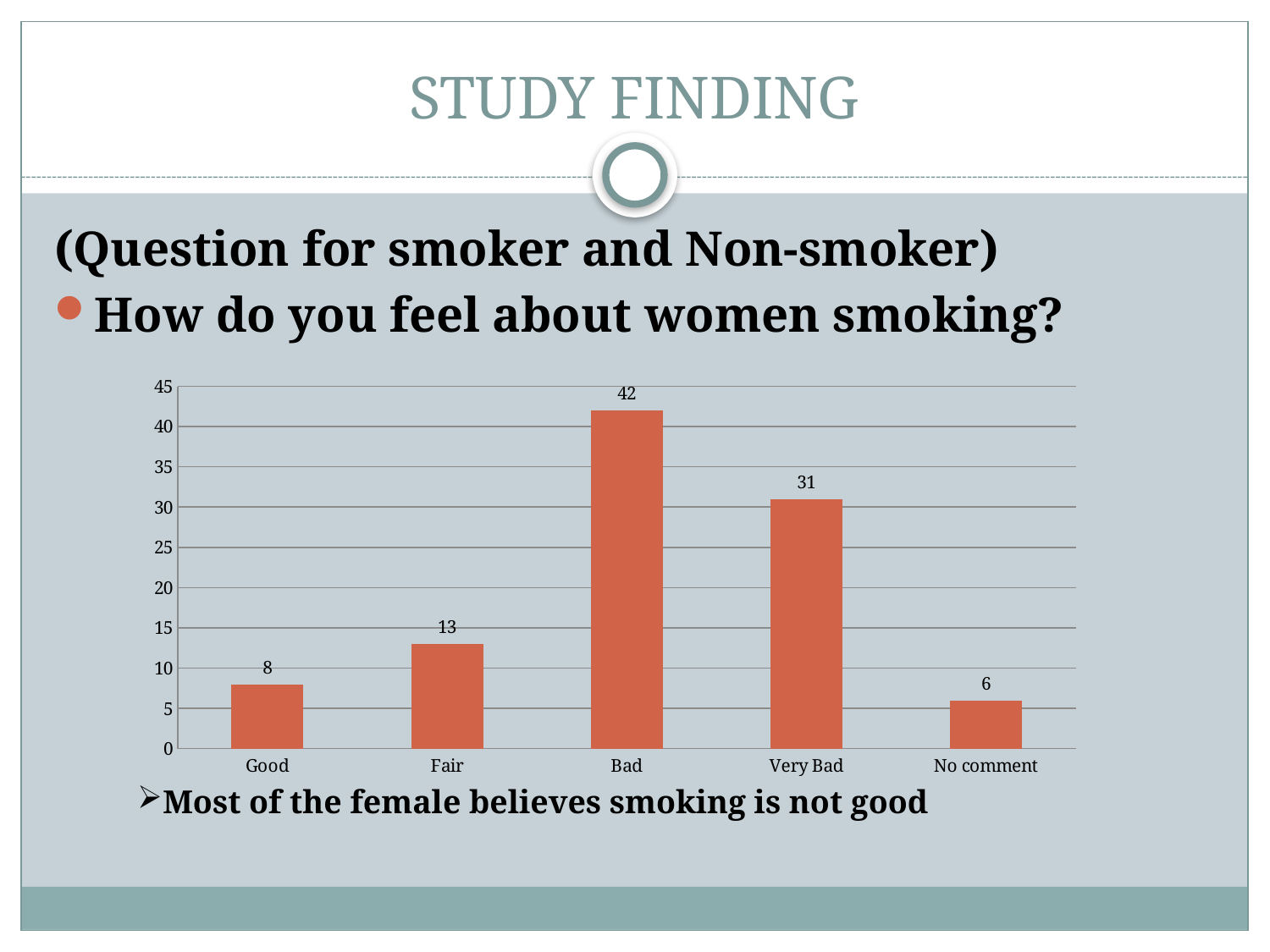
Is the value for Very Bad greater or less than 25? greater What is the difference between the values for Good and No comment? 2 What is the difference between the values for Bad and Very Bad? 11 What is the value for Fair? 13 What kind of chart is shown on the slide? bar chart How many categories are shown on the x axis? 5 What is the value for Bad? 42 What is the value for No comment? 6 What colour are the bars in the chart? orange Which category has the highest value? Bad Which category has the lowest value? No comment Which is larger, the value for Good or the value for Fair? Fair